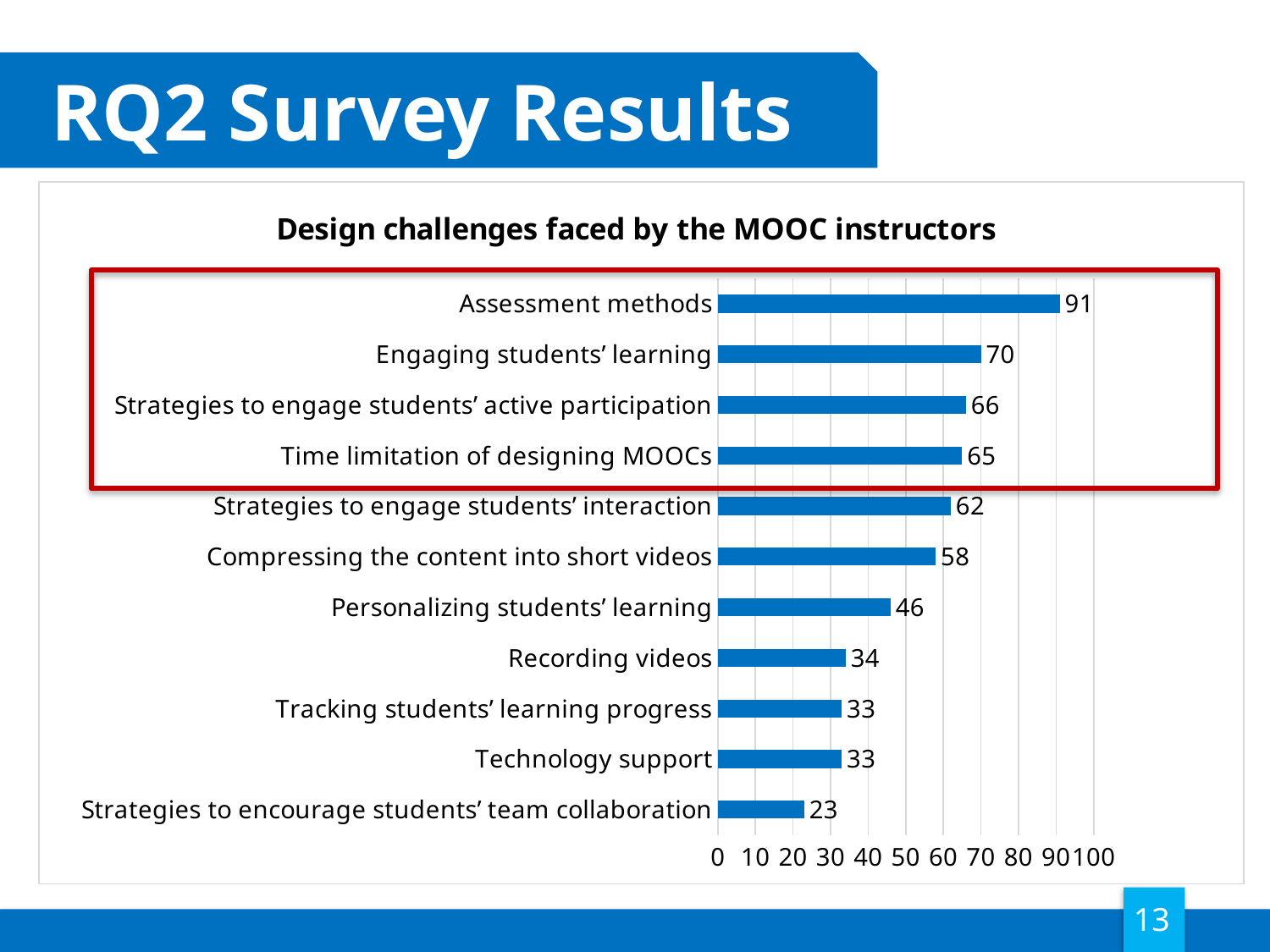
Which is larger: the value for Personalizing students' learning or the value for Strategies to engage students' interaction? Strategies to engage students' interaction How many design challenges are shown in the chart? 11 How many categories are enclosed by the red box on the chart? 4 Which design challenge has the highest value? Assessment methods What is the value for Assessment methods? 91 What kind of chart is shown on the slide? Bar chart What is the value for Recording videos? 34 Which design challenge has the lowest value? Strategies to encourage students' team collaboration What is the difference between the values for Assessment methods and Engaging students' learning? 21 Is the value for Time limitation of designing MOOCs greater or less than 50? greater What is the title of the chart? Design challenges faced by the MOOC instructors What is the value for Compressing the content into short videos? 58